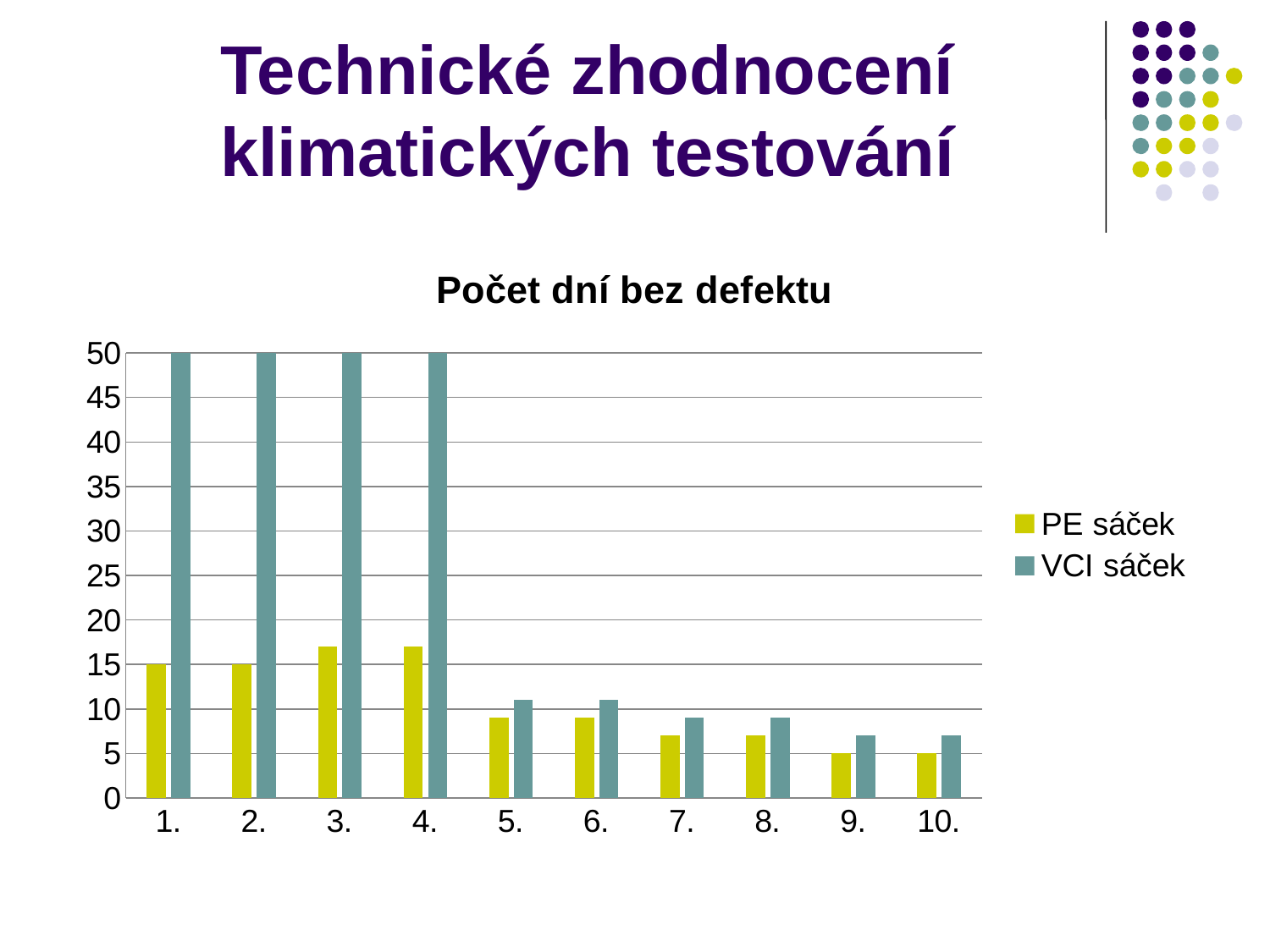
What is the value for PE sáček at category 2.? 15 How many categories are shown on the x axis? 10 How many series does the legend list? 2 What is the difference between VCI sáček and PE sáček at category 1.? 35 Is the value for PE sáček at category 7. greater or less than 10? less Do the VCI sáček values rise or fall from category 1. to category 10.? fall Is the value for VCI sáček at category 5. greater or less than 15? less What is the value for PE sáček at category 10.? 5 Which is larger at category 4., PE sáček or VCI sáček? VCI sáček Is the value for PE sáček at category 3. greater or less than 20? less What is the value for VCI sáček at category 1.? 50 What kind of chart is shown on the slide? bar chart